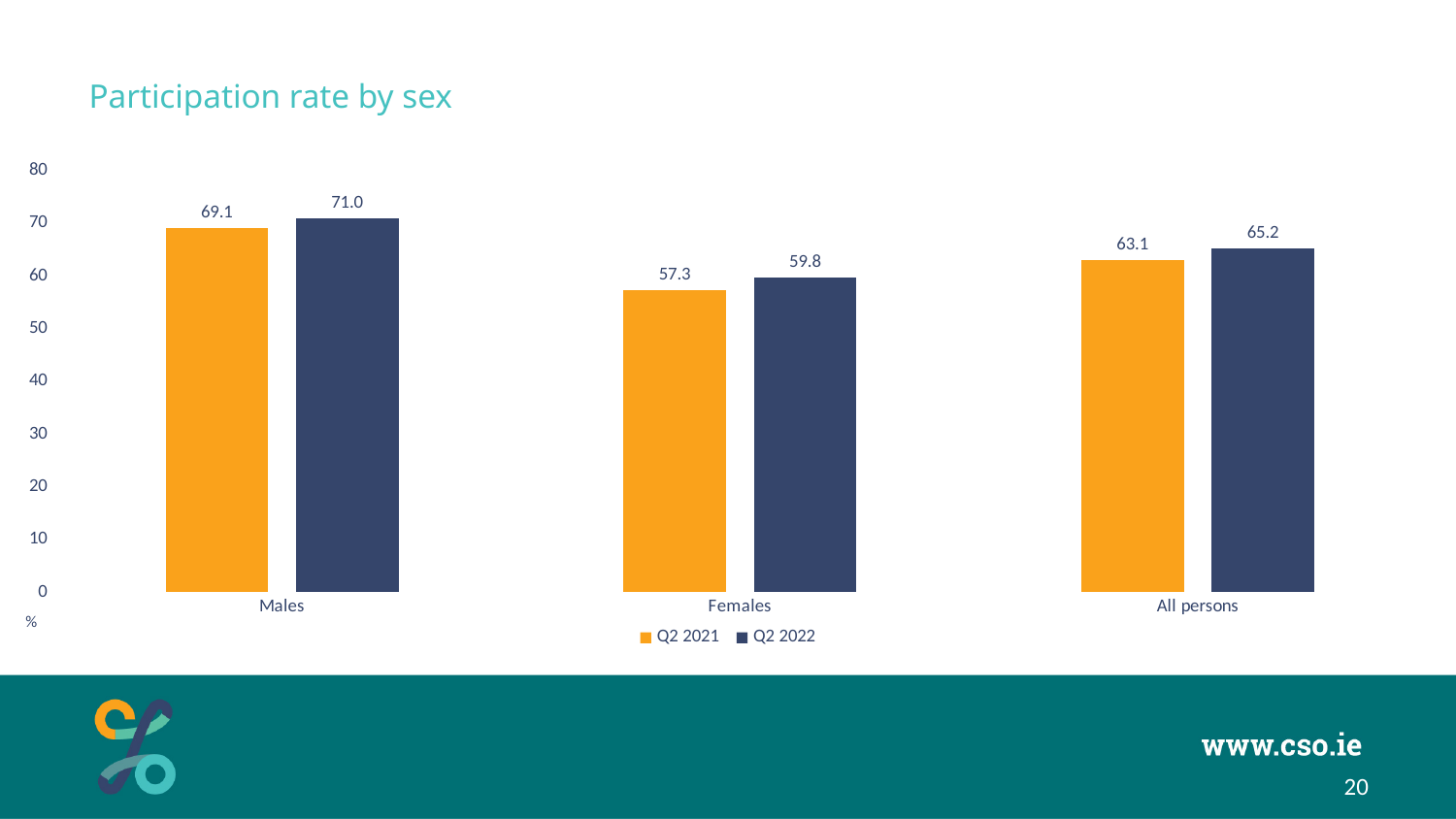
Is the Q2 2021 participation rate for Females greater or less than 60? less What is the participation rate for Males in Q2 2022? 71.0 Which category has the highest participation rate in Q2 2021? Males What kind of chart is shown on the slide? Bar chart Which category has the lowest participation rate in Q2 2022? Females How many categories are shown on the x axis? 3 What is the difference between the Q2 2022 and Q2 2021 participation rates for Females? 2.5 What is the difference between the Males and Females participation rates in Q2 2022? 11.2 What is the participation rate for All persons in Q2 2022? 65.2 What is the participation rate for Females in Q2 2021? 57.3 Which is larger: the Q2 2021 rate for Males or the Q2 2022 rate for All persons? Q2 2021 rate for Males How many series does the legend list? 2